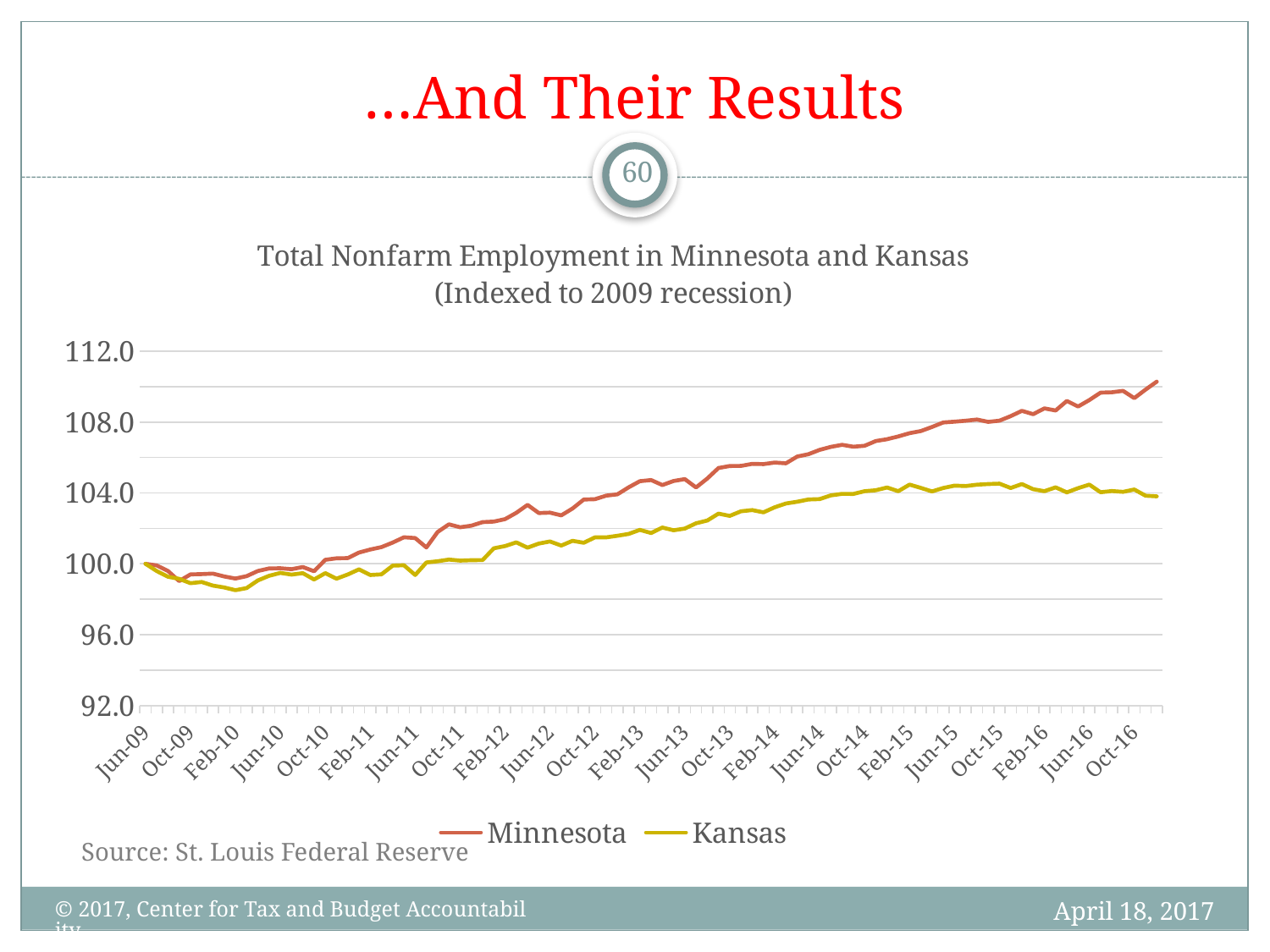
What kind of chart is shown on the slide? line chart Is the value for Minnesota at Jun-12 greater or less than 104.0? less Is the value for Minnesota at Oct-16 greater or less than 108.0? greater Is the value for Kansas at Feb-10 greater or less than 100.0? less Does the Minnesota line generally rise or fall from Jun-09 to Oct-16? rise What is the title of the chart? Total Nonfarm Employment in Minnesota and Kansas (Indexed to 2009 recession) What is the value for Minnesota at Jun-09? 100.0 How many series does the legend list? 2 Which two series are listed in the legend? Minnesota and Kansas At Oct-16, which series has the higher value, Minnesota or Kansas? Minnesota